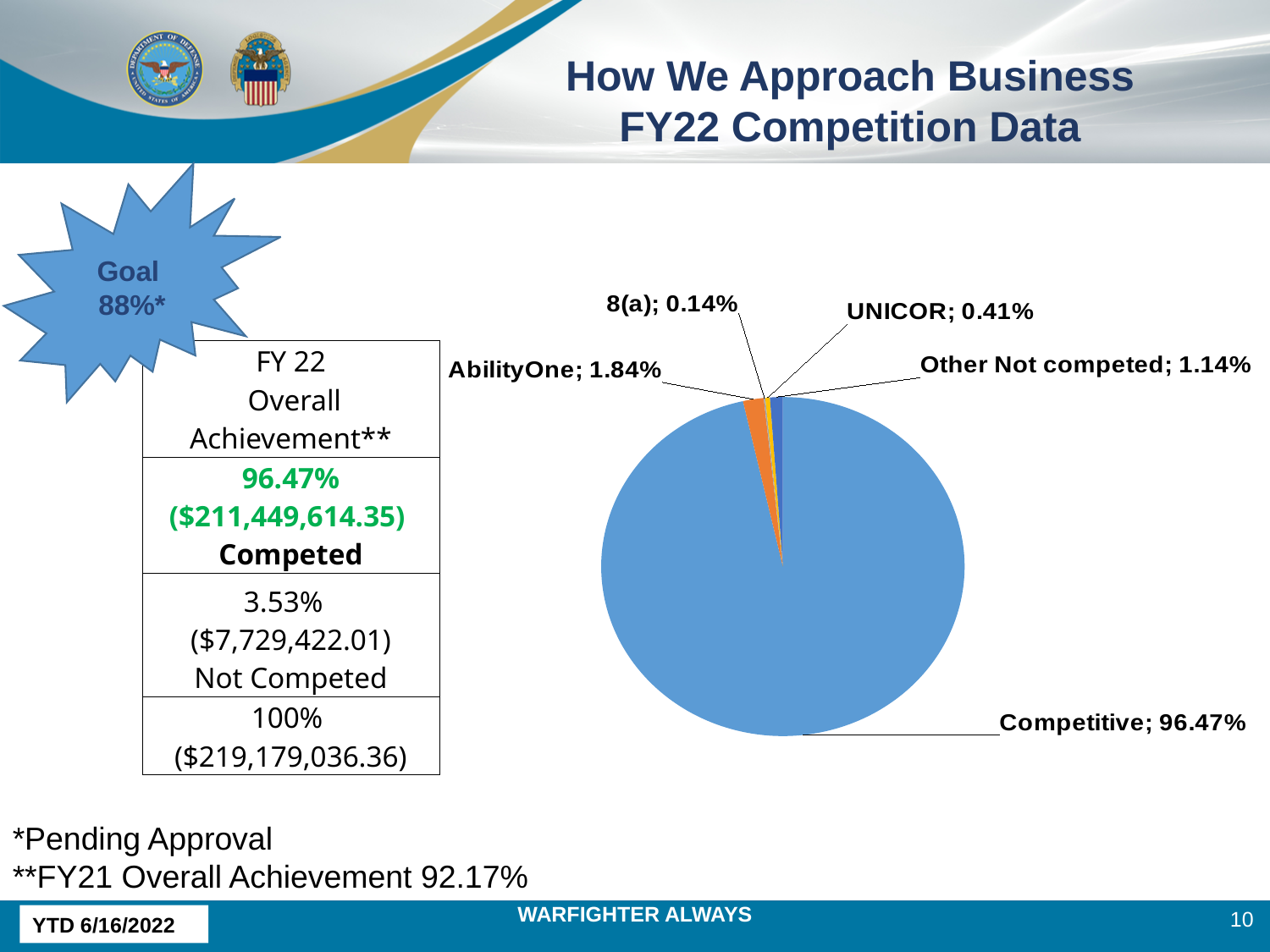
What is the value shown for 8(a)? 0.14% How many slices does the pie chart have? 5 What is the value shown for Other Not competed? 1.14% What is the value shown for AbilityOne? 1.84% What share of the pie does Competitive represent? 96.47% Which is larger, the UNICOR slice or the 8(a) slice? UNICOR What is the combined value of the AbilityOne and UNICOR slices? 2.25% What kind of chart is shown on the slide? pie chart Which slice of the pie is the smallest? 8(a) What is the value shown for UNICOR? 0.41% Which slice of the pie is the largest? Competitive What is the difference between the AbilityOne and Other Not competed values? 0.70%